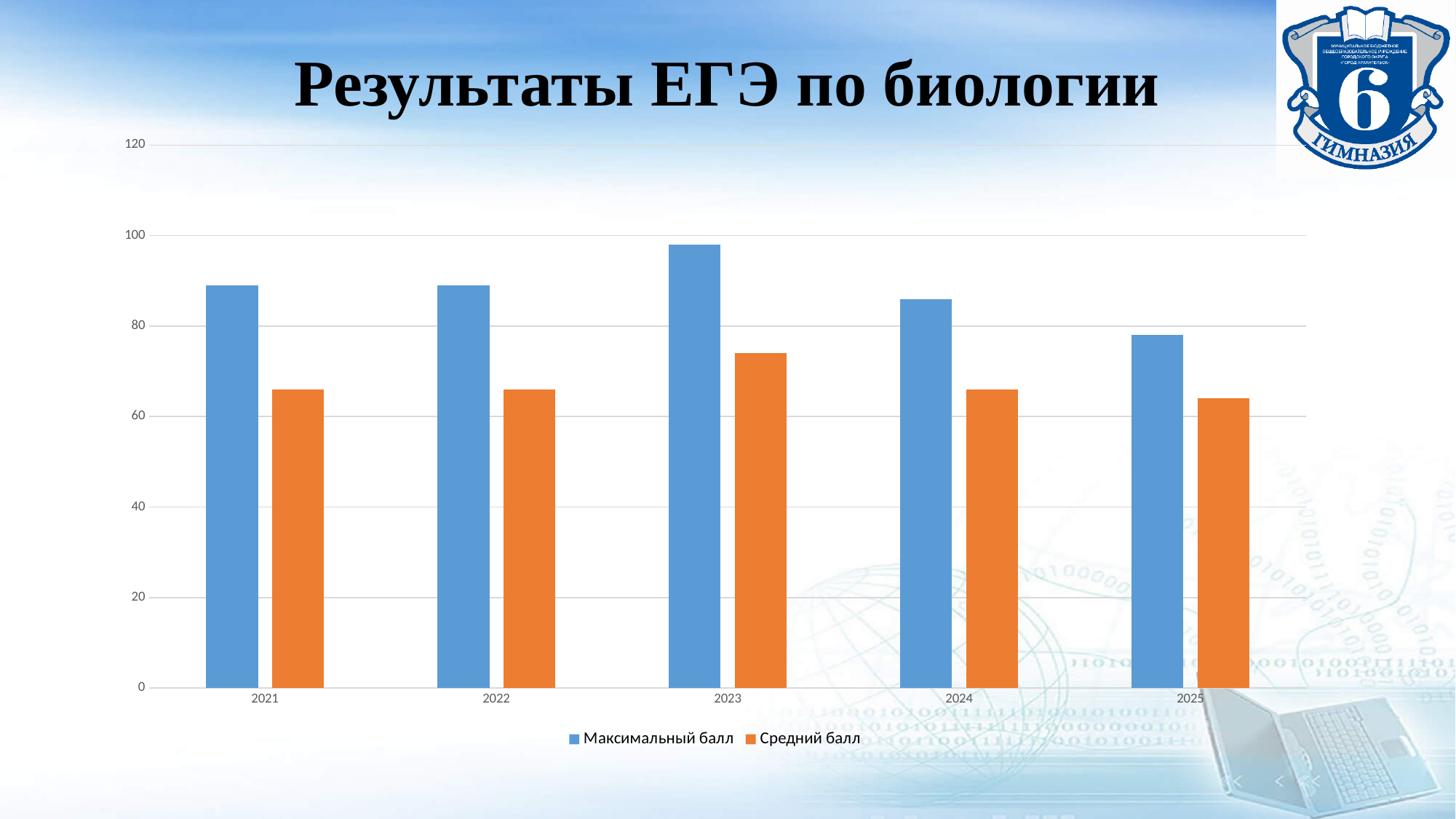
Which is larger: Максимальный балл in 2023 or in 2024? 2023 In which year is Средний балл the highest? 2023 Which series is shown in orange? Средний балл In which year is Максимальный балл the highest? 2023 How many years are shown on the x axis? 5 How many series does the legend list? 2 What is the title of the chart? Результаты ЕГЭ по биологии Does Максимальный балл rise or fall from 2023 to 2025? fall Is the value for Максимальный балл in 2023 greater or less than 80? greater In which year is Максимальный балл the lowest? 2025 What kind of chart is shown on the slide? bar chart Is the value for Средний балл in 2023 greater or less than 80? less